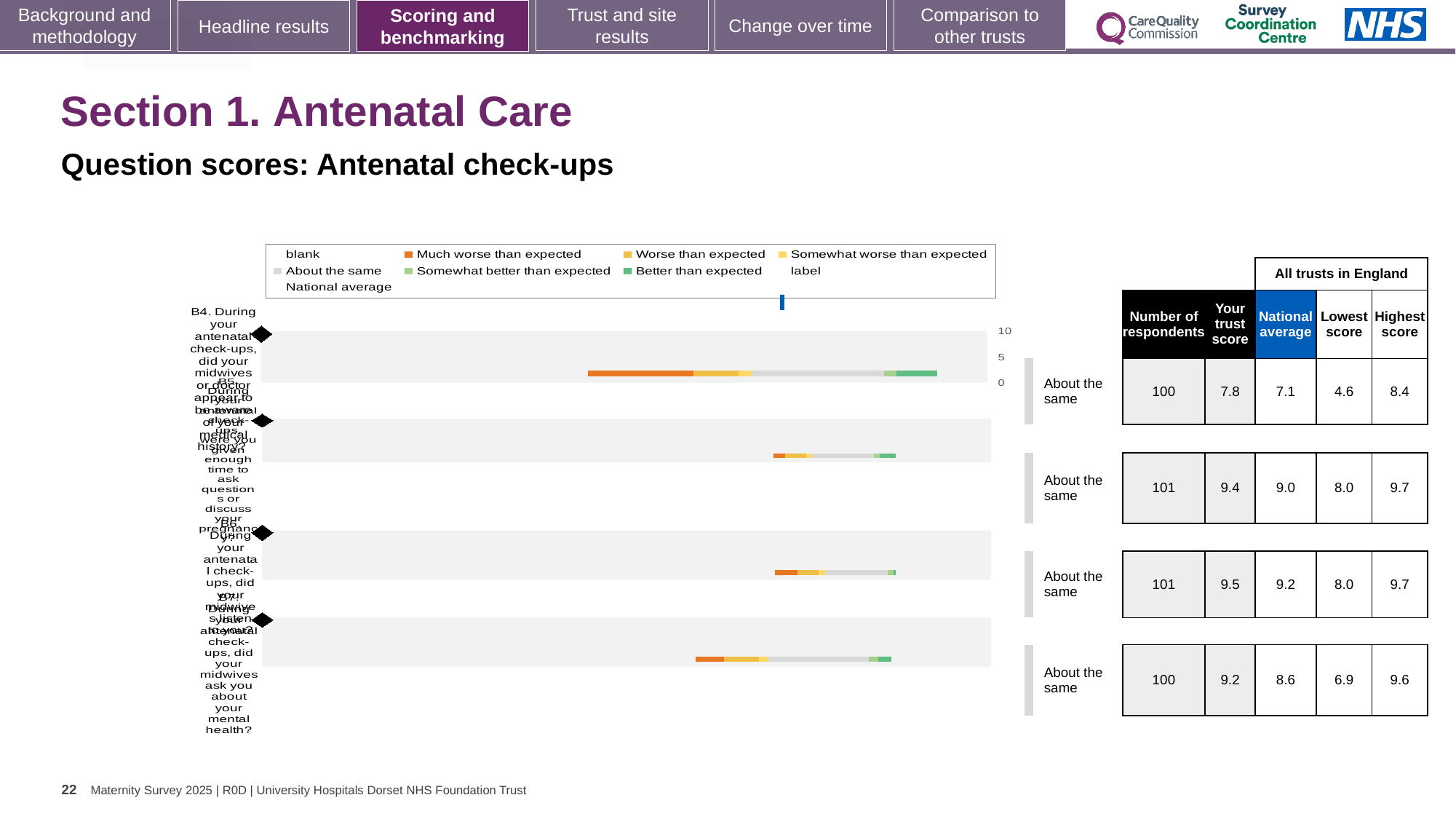
According to the table beside the chart, how many respondents answered the second question (B5)? 101 Which of the four questions has the lowest 'Your trust score' in the table beside the chart? the first question (B4), 7.8 How many survey questions (bars) are plotted in the chart? 4 What type of chart is shown on the slide? bar chart According to the table beside the chart, what is the national average for question B4 (the first bar)? 7.1 Which of the four questions has the highest 'Your trust score' in the table beside the chart? the third question (B6), 9.5 What is the difference between the trust score and the national average for question B4 (the first bar)? 0.7 For the fourth question (B7), which is larger: the trust score or the national average? the trust score (9.2) In the chart legend, which colour represents 'Better than expected'? green According to the table beside the chart, what is the 'Your trust score' for question B4 (the first bar)? 7.8 According to the table beside the chart, what is the highest score among all trusts in England for the fourth question (B7)? 9.6 In the chart legend, which colour represents 'Much worse than expected'? orange